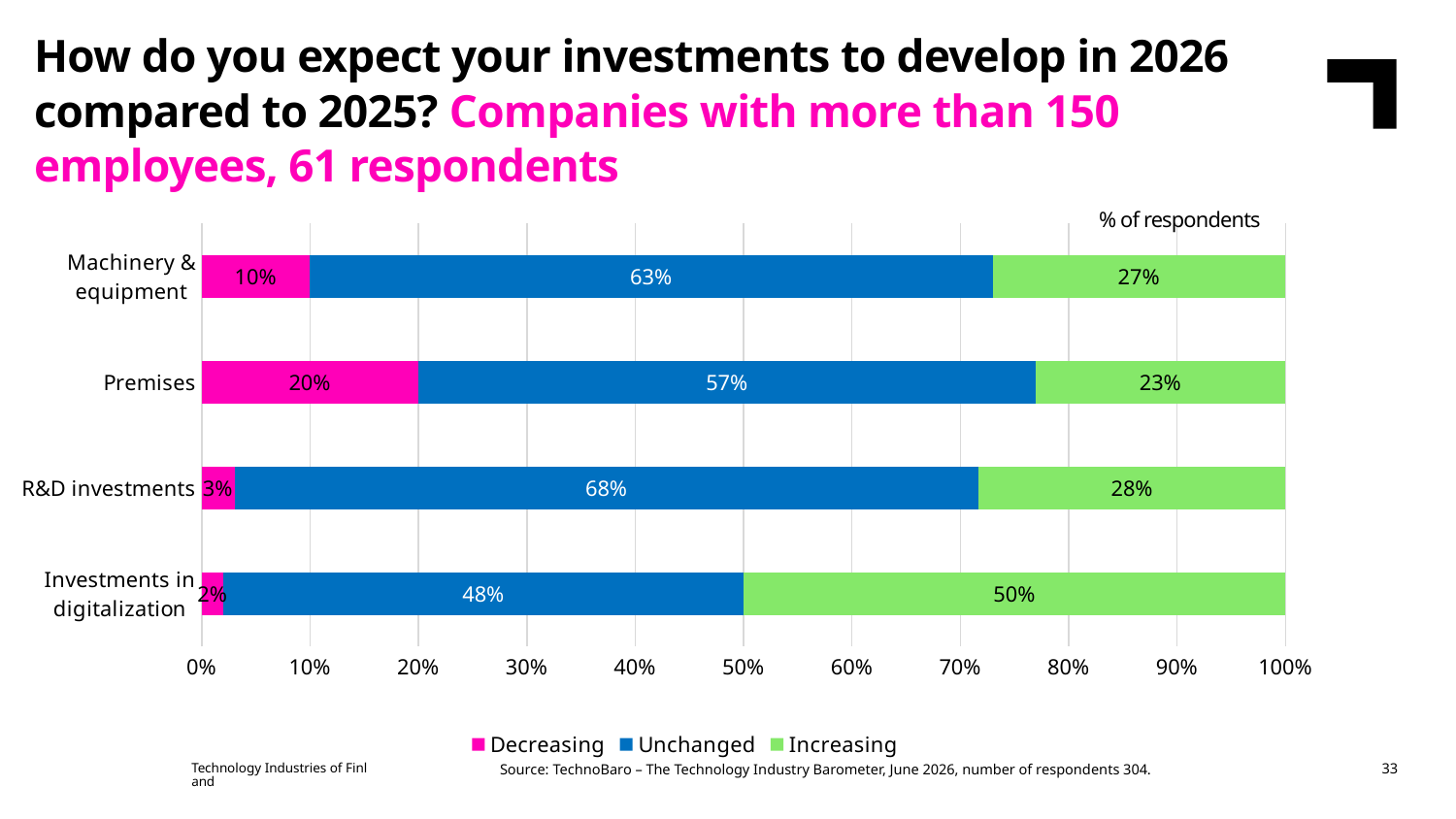
How many series does the legend list? 3 What percentage of respondents expect Investments in digitalization to be Increasing? 50% How many investment categories are shown on the chart? 4 What is the difference between the Increasing share for Investments in digitalization and the Increasing share for Premises? 27 percentage points What percentage of respondents expect Machinery & equipment investments to be Unchanged? 63% Which category has the highest share of respondents expecting Increasing investments? Investments in digitalization What percentage of respondents expect R&D investments to be Decreasing? 3% What percentage of respondents expect Premises investments to be Decreasing? 20% What is the total of the three segments for the Premises bar? 100% Which is larger: the Unchanged share for R&D investments or the Unchanged share for Premises? R&D investments Which category has the lowest share of respondents expecting Decreasing investments? Investments in digitalization What kind of chart is shown on the slide? Stacked bar chart